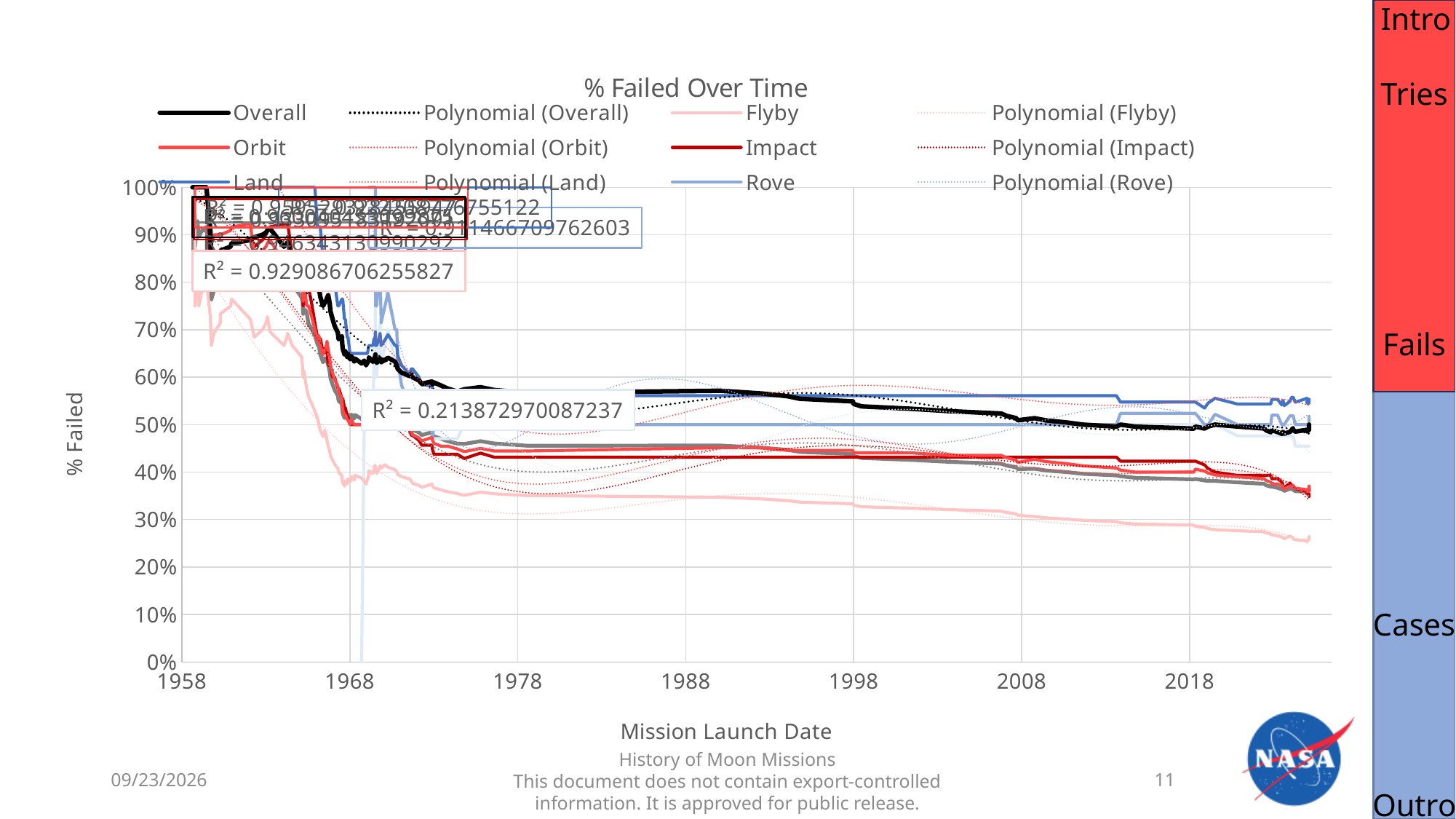
Is the value of the Impact line at 1998 greater or less than 50%? less Is the value of the Overall line at 1988 greater or less than 50%? greater What is the label of the x axis? Mission Launch Date What kind of chart is shown on the slide? line chart Is the value of the Land line at 2008 greater or less than 50%? greater Which series has the lowest value at the right end of the chart? Flyby Does the Flyby line rise or fall from 1958 to the right end of the chart? fall What is the title of the chart? % Failed Over Time At 2018, which is higher, the Land line or the Flyby line? Land Does the Overall line rise or fall from 1958 to the right end of the chart? fall How many entries does the chart legend list? 12